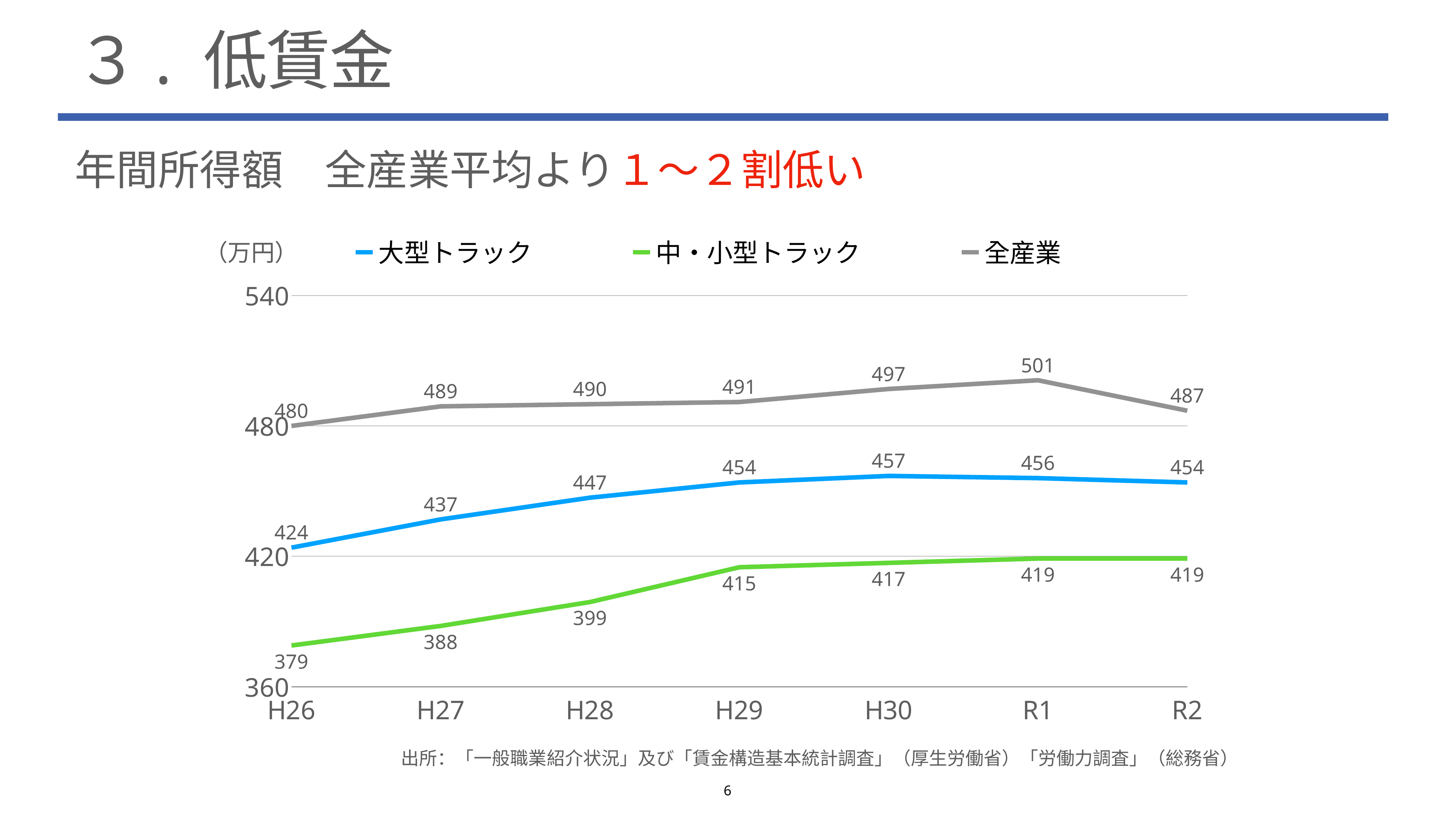
Does the 中・小型トラック series rise or fall from H26 to H29? rise What unit is shown at the top left of the chart? （万円） How many years are shown on the x axis? 7 In which year is the 全産業 series highest? R1 What is the value for 中・小型トラック in H26? 379 What is the value for 大型トラック in H28? 447 How many series does the legend list? 3 What kind of chart is shown on the slide? line chart In which year is the 中・小型トラック series lowest? H26 What is the value for 全産業 in R1? 501 Which is larger in H29: 大型トラック or 中・小型トラック? 大型トラック What is the difference between 全産業 and 大型トラック in H30? 40